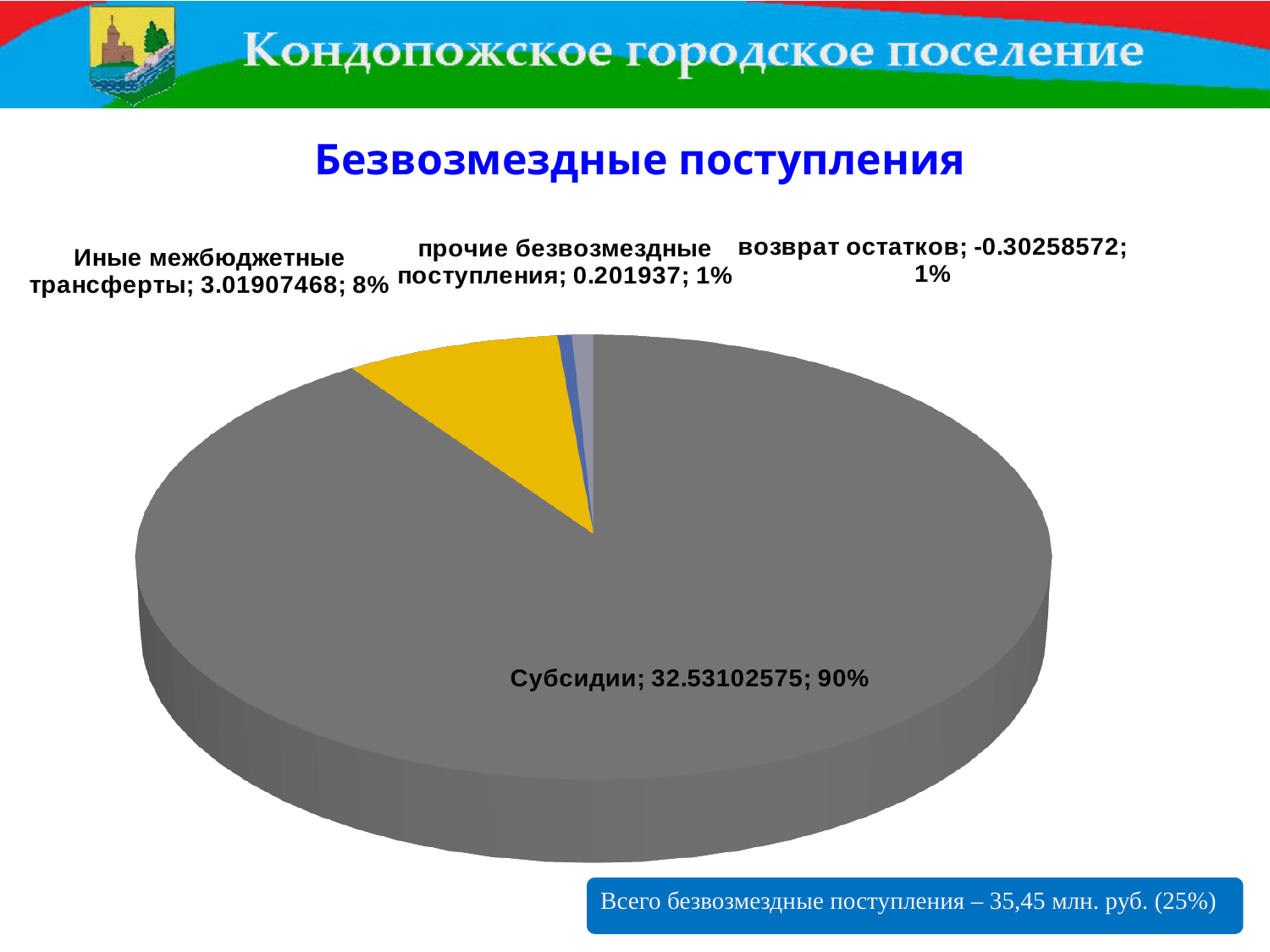
How many slices does the pie chart have? 4 What kind of chart is shown on the slide? pie chart What is the value for прочие безвозмездные поступления? 0.201937 Which is larger, the value for Иные межбюджетные трансферты or the value for прочие безвозмездные поступления? Иные межбюджетные трансферты What is the difference between the values for Субсидии and Иные межбюджетные трансферты? 29.51195107 Which category has the largest slice of the pie? Субсидии What is the value for Иные межбюджетные трансферты? 3.01907468 What share of the pie does Субсидии represent? 90% What is the title of the chart? Безвозмездные поступления What is the value for возврат остатков? -0.30258572 Which category has the lowest value? возврат остатков What is the value for Субсидии? 32.53102575